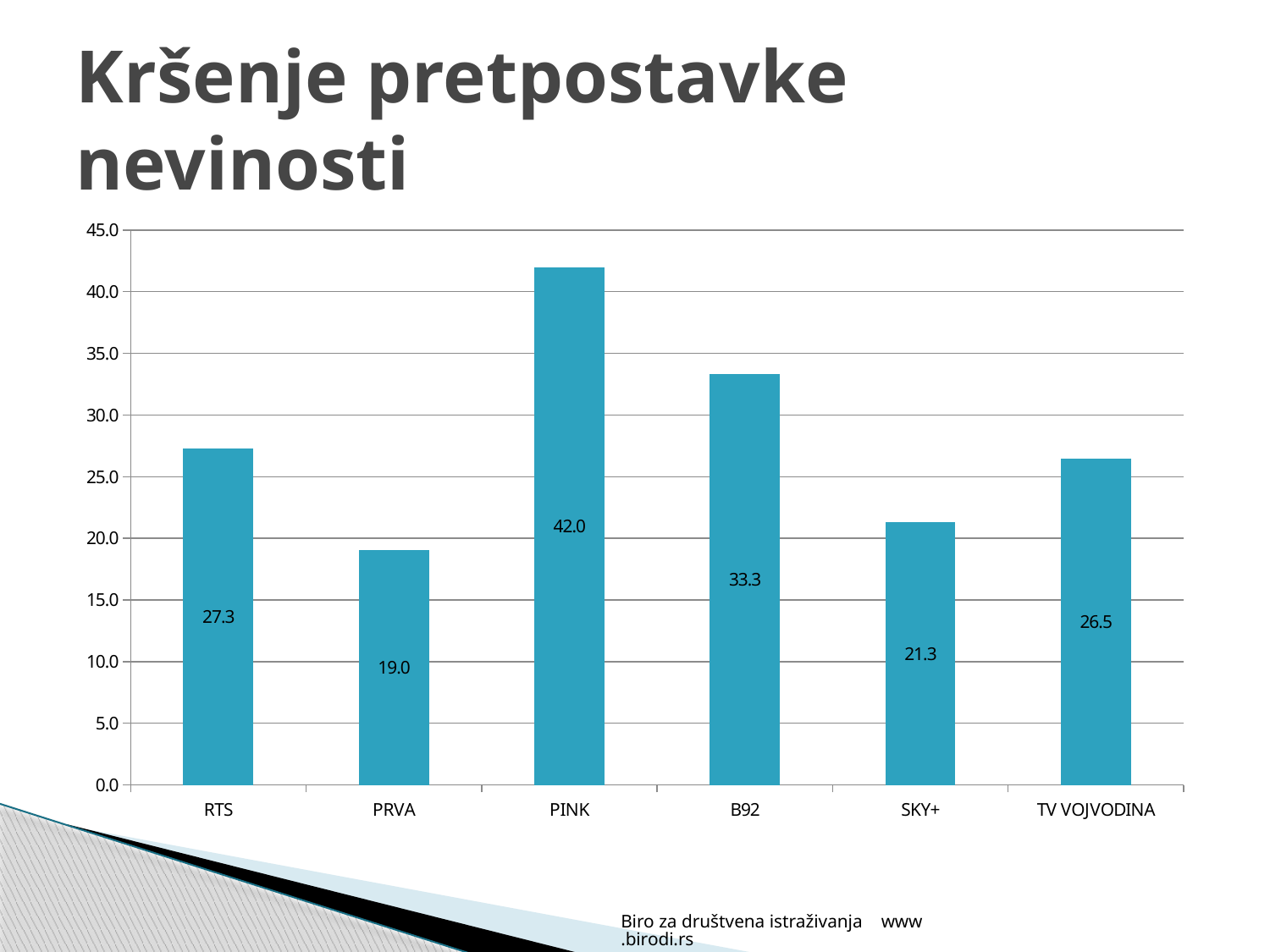
What is the value for PRVA? 19.0 What is the difference between the values for PINK and B92? 8.7 Which category has the lowest value? PRVA Is the value for B92 greater or less than 30.0? greater Which category has the highest value? PINK How many categories are shown on the x axis? 6 What is the title of the slide? Kršenje pretpostavke nevinosti What is the value for PINK? 42.0 What is the difference between the values for RTS and SKY+? 6.0 Which is larger, the value for RTS or the value for TV VOJVODINA? RTS What kind of chart is shown on the slide? bar chart What is the value for TV VOJVODINA? 26.5